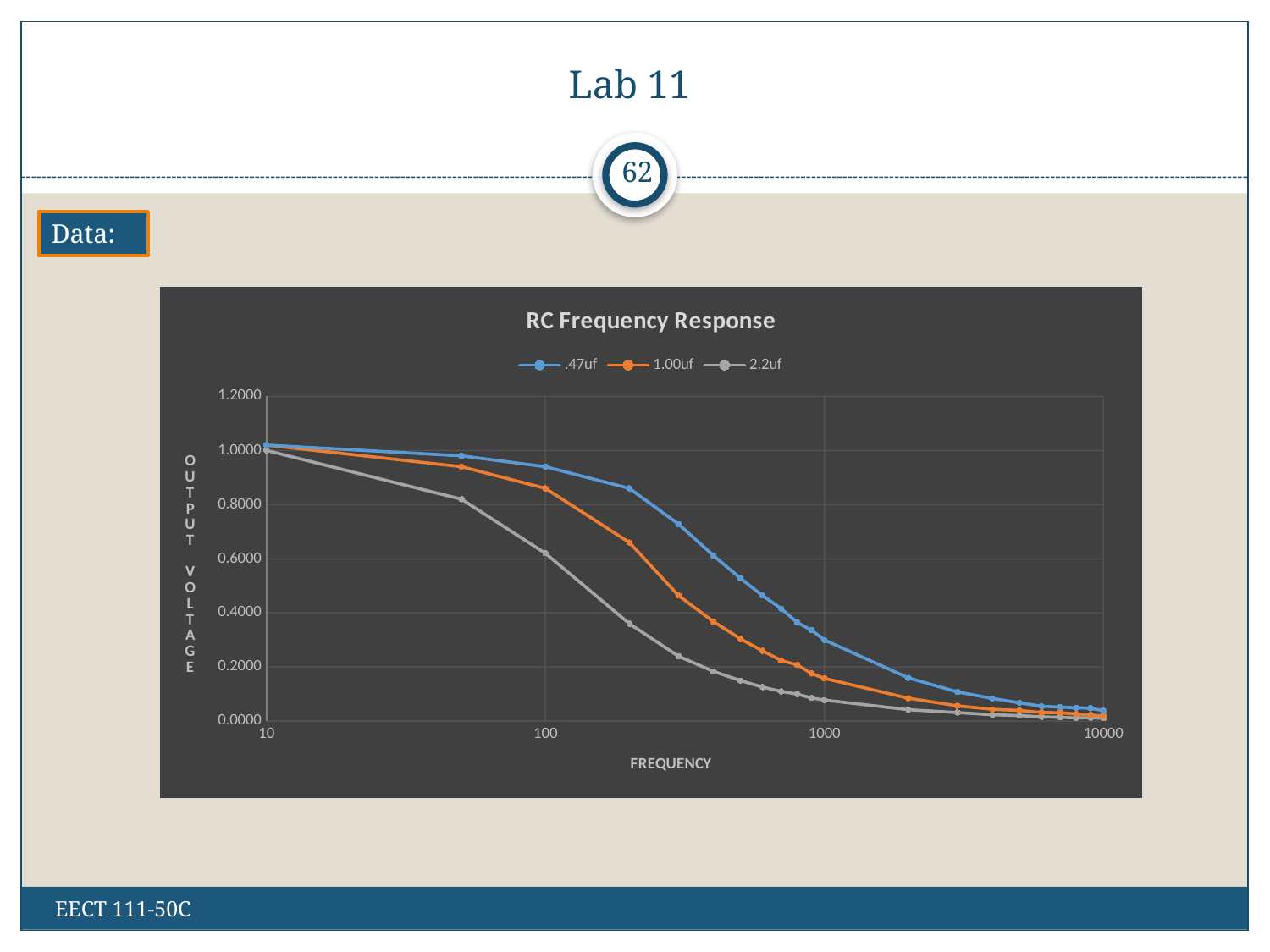
At a frequency of 100, is the output voltage for the .47uf series greater or less than 0.8000? greater At a frequency of 100, which series has the larger output voltage, .47uf or 2.2uf? .47uf Which series has the highest output voltage at a frequency of 1000? .47uf At a frequency of 1000, which series has the larger output voltage, 1.00uf or 2.2uf? 1.00uf At a frequency of 1000, is the output voltage for the 2.2uf series greater or less than 0.2000? less What is the label of the x axis of the chart? FREQUENCY Which series has the lowest output voltage at a frequency of 100? 2.2uf Do the output voltage values rise or fall as frequency increases along the x axis? fall At a frequency of 1000, is the output voltage for the .47uf series greater or less than 0.4000? less What kind of chart is shown on the slide? line chart What is the title of the chart? RC Frequency Response How many series does the legend of the RC Frequency Response chart list? 3